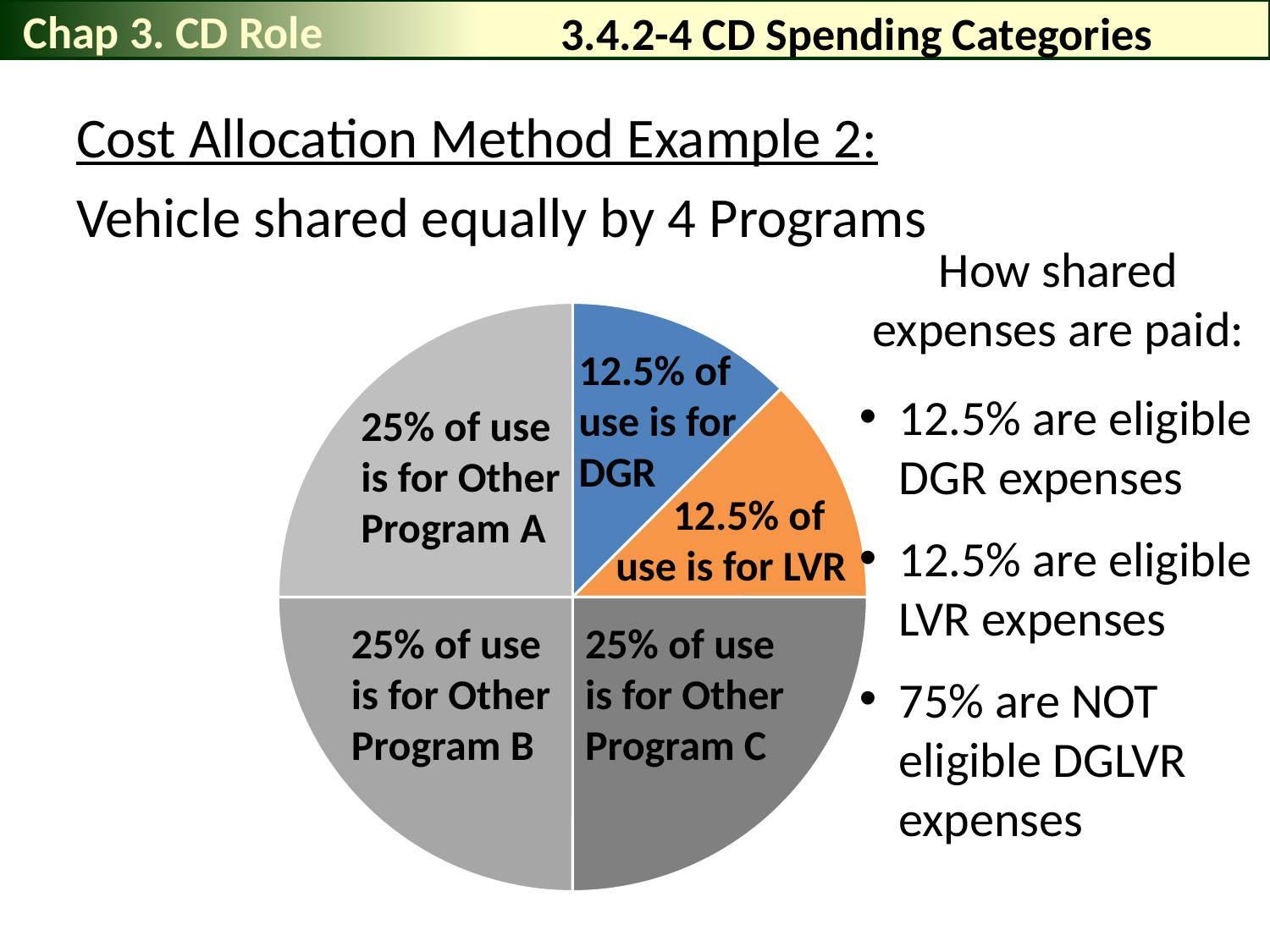
What colour is the slice for DGR in the pie chart? blue What is the difference between the share for Other Program A and the share for LVR? 12.5% What share of use is for LVR according to the pie chart? 12.5% How many slices does the pie chart have? 5 What kind of chart is shown on the slide? pie chart What share of use is for DGR according to the pie chart? 12.5% What colour is the slice for LVR in the pie chart? orange What is the combined share of use for Other Programs A, B and C? 75% Which is larger in the pie chart: the share for Other Program B or the share for DGR? Other Program B What share of use is for Other Program A? 25% What is the combined share of use for DGR and LVR in the pie chart? 25%